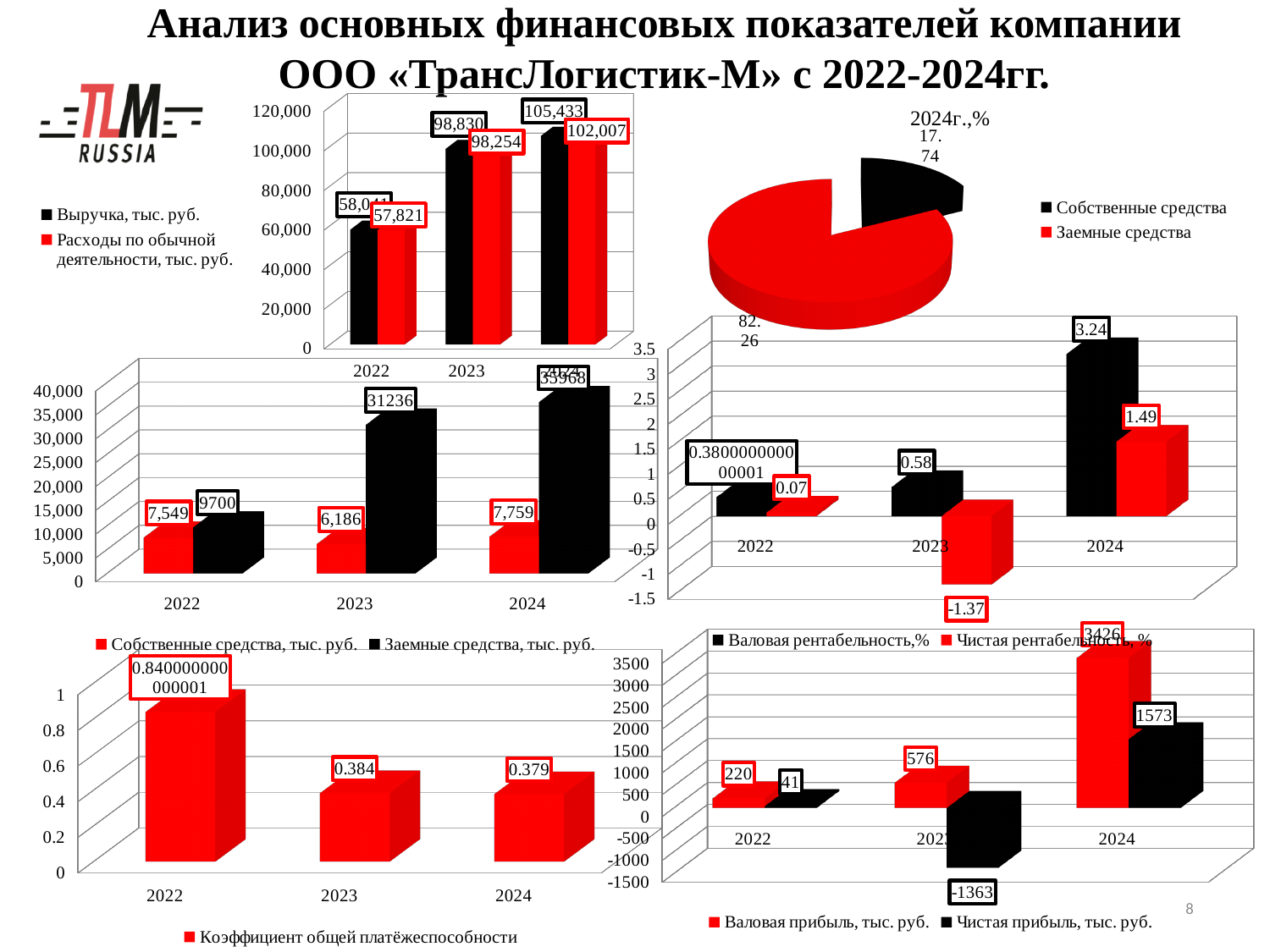
In the pie chart titled 2024г.,%, what share does Заемные средства have? 82.26 In the middle-right bar chart, what is the value of Чистая рентабельность, % for 2023? -1.37 In the bottom-right bar chart, which is larger in 2022: Валовая прибыль, тыс. руб. or Чистая прибыль, тыс. руб.? Валовая прибыль, тыс. руб. In the bottom-right bar chart, what is the difference between Валовая прибыль, тыс. руб. and Чистая прибыль, тыс. руб. in 2024? 1853 In the top-left bar chart, which year has the highest Выручка, тыс. руб.? 2024 In the middle-left bar chart, which year has the lowest Собственные средства, тыс. руб.? 2023 In the bottom-left bar chart, what is the Коэффициент общей платёжеспособности for 2023? 0.384 In the top-left bar chart, what is the value of Расходы по обычной деятельности, тыс. руб. for 2023? 98,254 In the middle-right bar chart, what is the value of Валовая рентабельность,% for 2024? 3.24 In the top-left bar chart, what is the value of Выручка, тыс. руб. for 2024? 105,433 In the middle-left bar chart, what is the value of Заемные средства, тыс. руб. for 2023? 31236 In the pie chart titled 2024г.,%, how many slices are there? 2